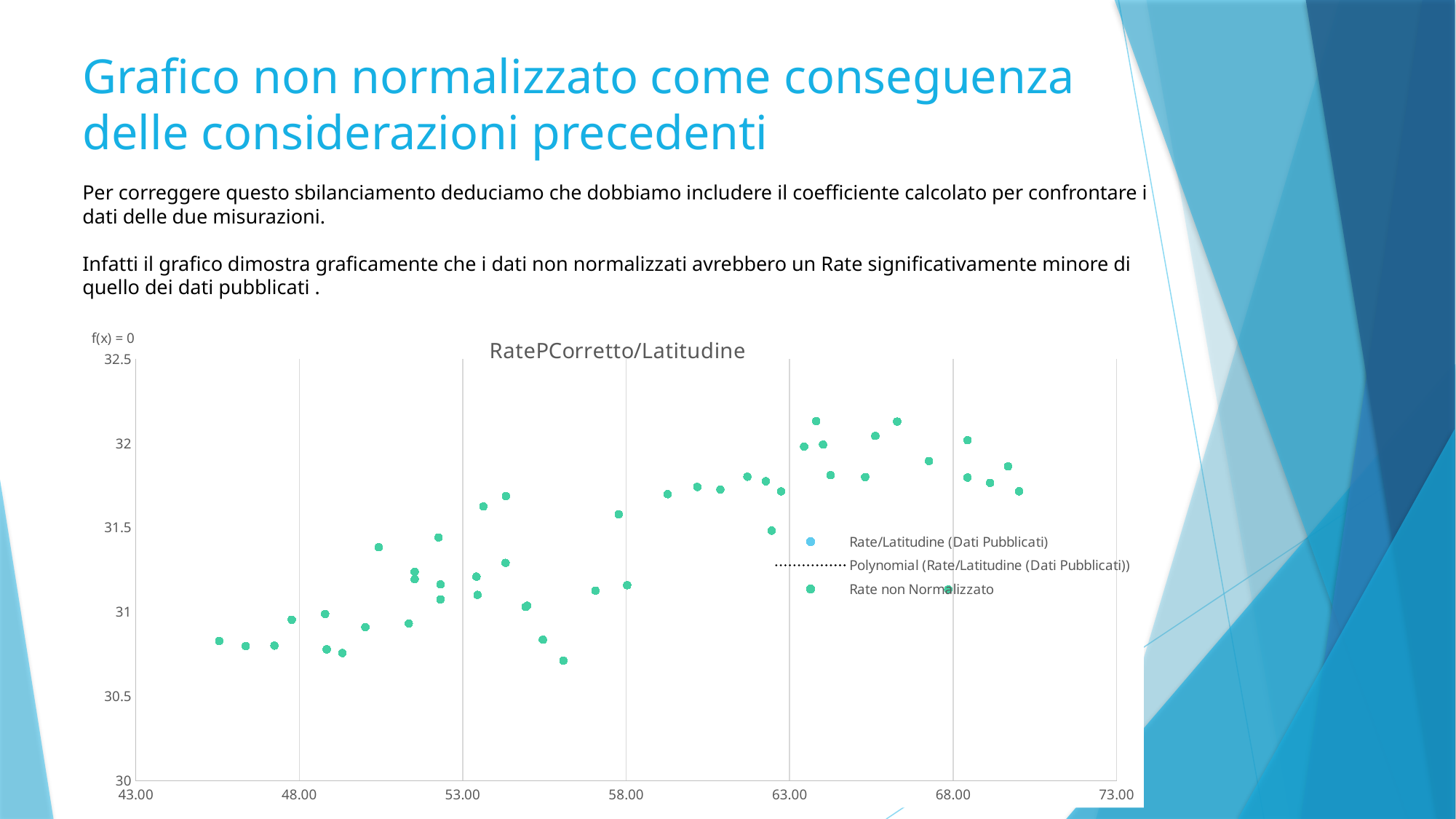
Is the highest Rate non Normalizzato value greater or less than 32.5? less Are the Rate non Normalizzato values plotted near latitude 68.00 greater or less than 31.5? greater Is the lowest Rate non Normalizzato value greater or less than 30.5? greater How many entries does the chart legend list? 3 What kind of chart is shown on the slide? scatter chart Which legend entry is shown with a dotted line? Polynomial (Rate/Latitudine (Dati Pubblicati)) Do the Rate non Normalizzato values generally rise or fall as latitude increases along the x axis? rise What is the title of the chart? RatePCorretto/Latitudine